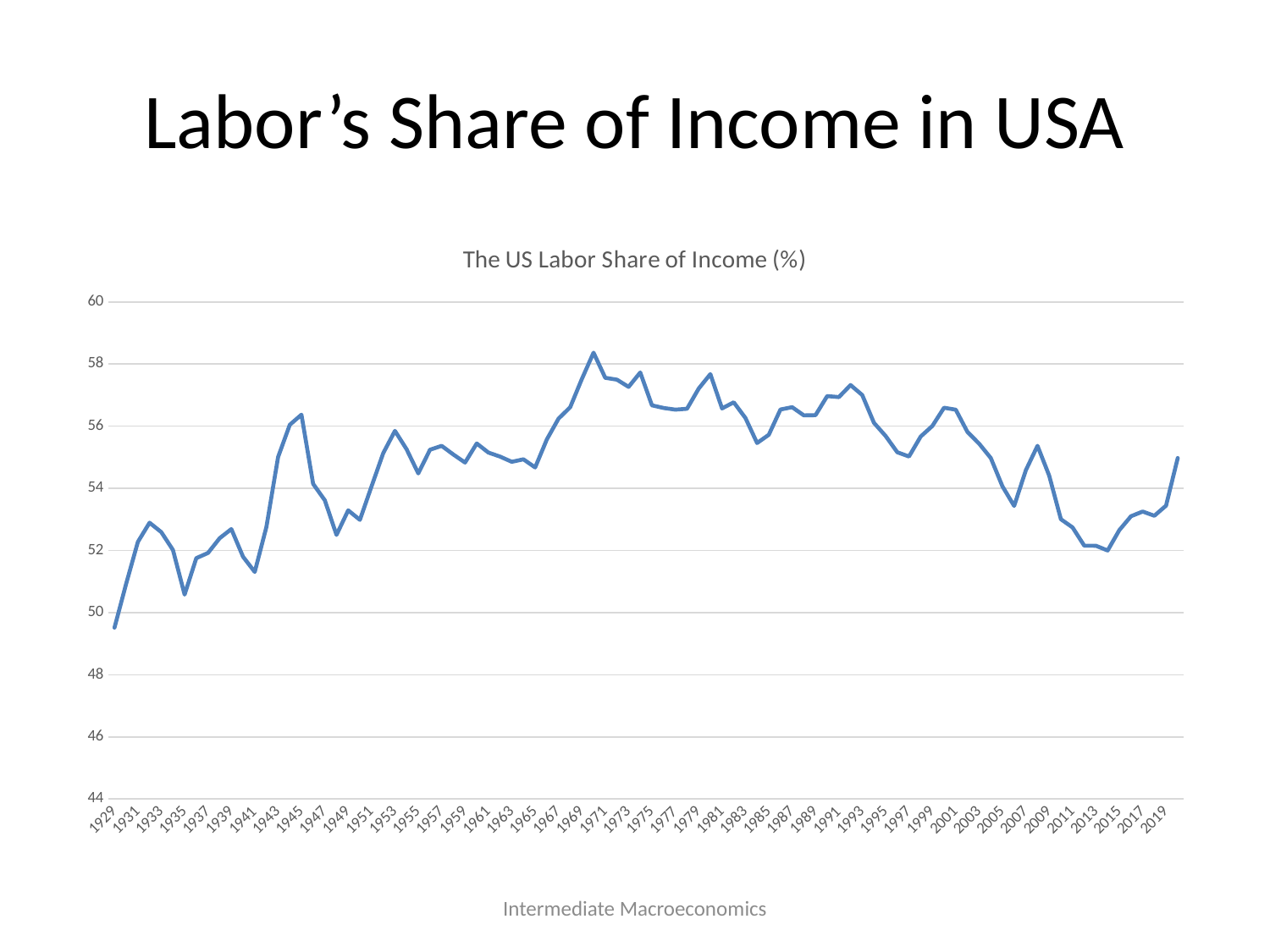
Is the labor share of income in 1929 greater or less than 50? less In which year is the US labor share of income at its lowest? 1929 Is the labor share of income in 2014 greater or less than 54? less What kind of chart is shown on the slide? line chart What is the title of the chart? The US Labor Share of Income (%) Does the labor share of income generally rise or fall between 2001 and 2014? fall Is the labor share of income in 1935 greater or less than 52? less Which year has a higher labor share of income, 1970 or 2014? 1970 Does the labor share of income generally rise or fall between 1929 and 1945? rise In which year does the US labor share of income reach its highest point? 1970